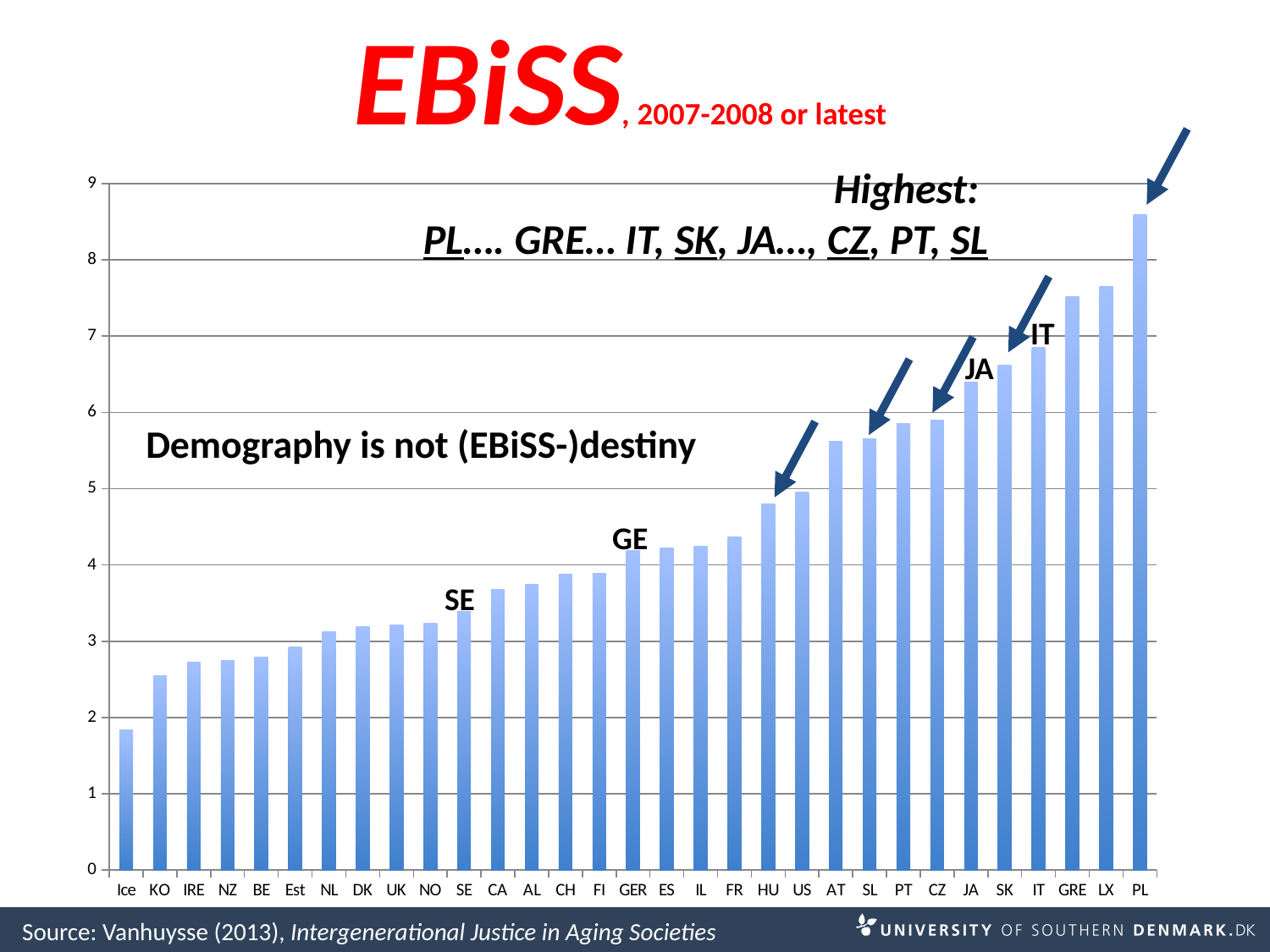
Do the bar values rise or fall moving from left to right along the x axis? rise Which has the larger value, JA or HU? JA What kind of chart is shown on the slide? bar chart Is the value for GRE greater or less than 7? greater What period does the chart title say the EBiSS data refers to? 2007-2008 or latest Which country has the highest EBiSS value in the chart? PL How many countries are shown on the x axis of the chart? 31 Which country has the lowest EBiSS value in the chart? Ice Is the value for PL greater or less than 8? greater Is the value for CA greater or less than 4? less